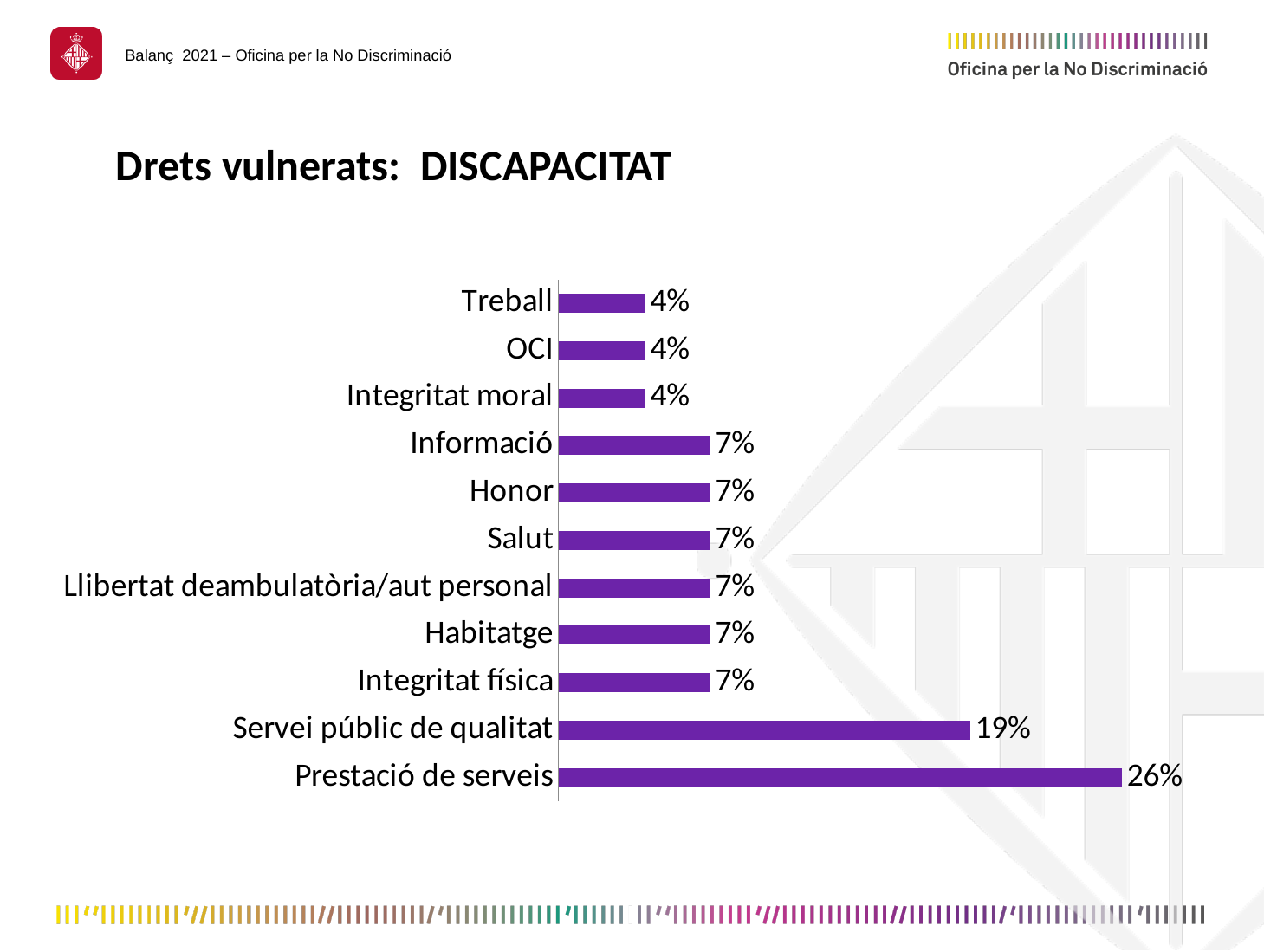
Which category has the highest value? Prestació de serveis What kind of chart is shown on the slide? Bar chart How many categories are shown in the chart? 11 What is the difference between Prestació de serveis and Servei públic de qualitat? 7% How many categories have a value of 7%? 6 What is the value for Treball? 4% What is the title of the slide containing the chart? Drets vulnerats: DISCAPACITAT Which is larger, Servei públic de qualitat or Salut? Servei públic de qualitat What is the difference between Informació and OCI? 3% What is the value for Servei públic de qualitat? 19% What is the value for Habitatge? 7% What is the value for Prestació de serveis? 26%